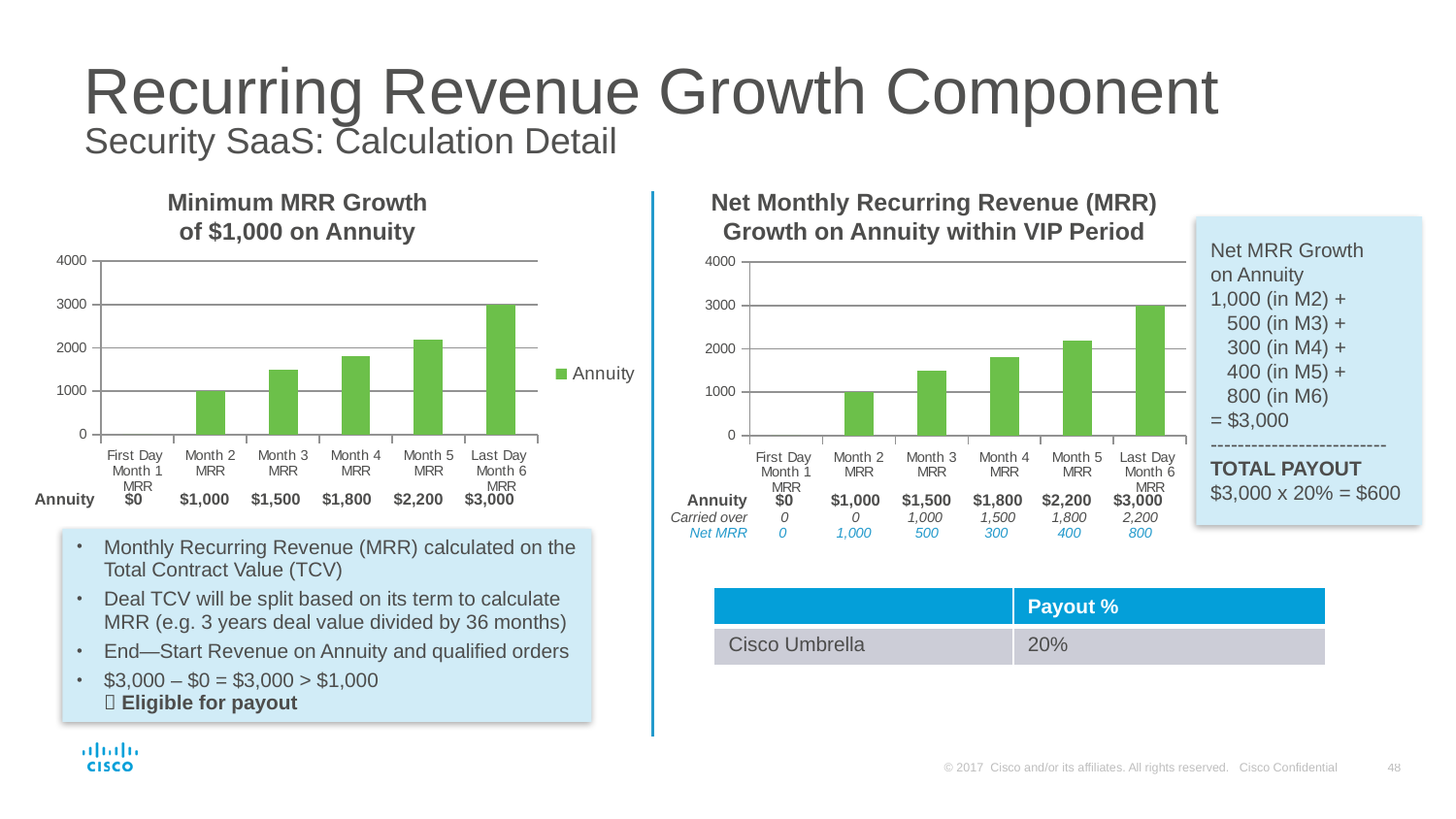
In the 'Minimum MRR Growth of $1,000 on Annuity' chart, which category has the highest Annuity value? Last Day Month 6 MRR In the 'Net Monthly Recurring Revenue (MRR) Growth on Annuity within VIP Period' chart, do the Annuity values rise or fall from Month 1 to Month 6? Rise In the 'Minimum MRR Growth of $1,000 on Annuity' chart, how many series does the legend list? 1 In the 'Minimum MRR Growth of $1,000 on Annuity' chart, what is the Annuity value for Month 3 MRR? $1,500 In the 'Net Monthly Recurring Revenue (MRR) Growth on Annuity within VIP Period' chart, which is larger: the Annuity value for Month 2 MRR or Month 3 MRR? Month 3 MRR In the 'Net Monthly Recurring Revenue (MRR) Growth on Annuity within VIP Period' chart, is the Annuity value for Month 4 MRR greater or less than 2000? less In the 'Net Monthly Recurring Revenue (MRR) Growth on Annuity within VIP Period' chart, what is the Annuity value for Month 5 MRR? $2,200 In the 'Net Monthly Recurring Revenue (MRR) Growth on Annuity within VIP Period' chart, what is the Net MRR value shown for Last Day Month 6 MRR? 800 In the 'Minimum MRR Growth of $1,000 on Annuity' chart, which category has the lowest Annuity value? First Day Month 1 MRR In the 'Minimum MRR Growth of $1,000 on Annuity' chart, how many categories are shown on the x axis? 6 In the 'Minimum MRR Growth of $1,000 on Annuity' chart, what is the difference between the Annuity values for Month 5 MRR and Month 4 MRR? $400 What kind of chart is the 'Minimum MRR Growth of $1,000 on Annuity' chart? Bar chart